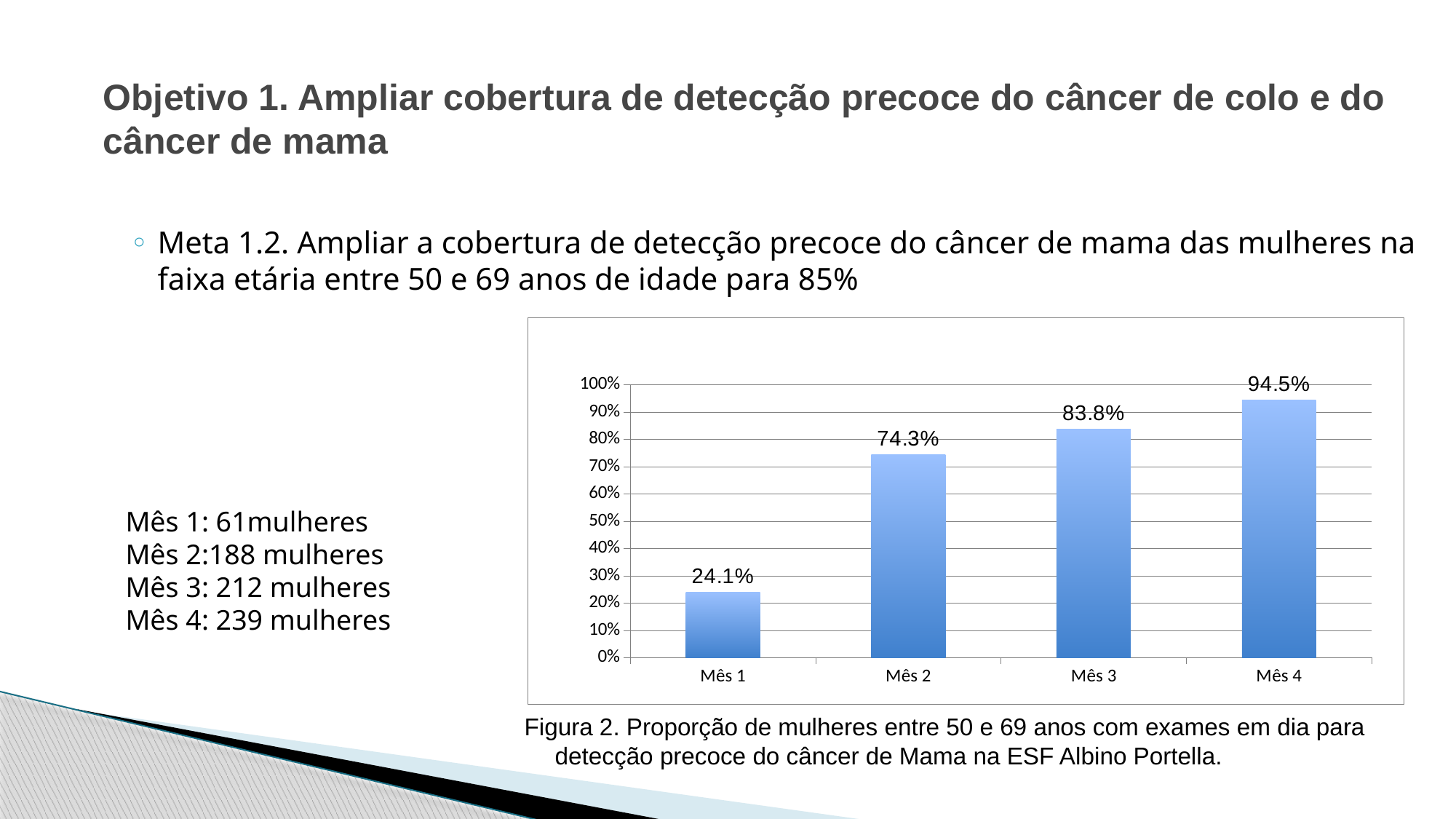
What is the value for Mês 4? 94.5% What is the value for Mês 3? 83.8% What is the difference between the values for Mês 2 and Mês 1? 50.2% What kind of chart is shown on the slide? Bar chart How many months are shown on the x axis? 4 What is the value for Mês 1? 24.1% What is the difference between the values for Mês 4 and Mês 3? 10.7% Which month has the lowest value? Mês 1 Is the value for Mês 2 greater or less than 70%? greater Which month has the highest value? Mês 4 Do the values rise or fall from Mês 1 to Mês 4? Rise Which is larger, the value for Mês 2 or the value for Mês 3? Mês 3